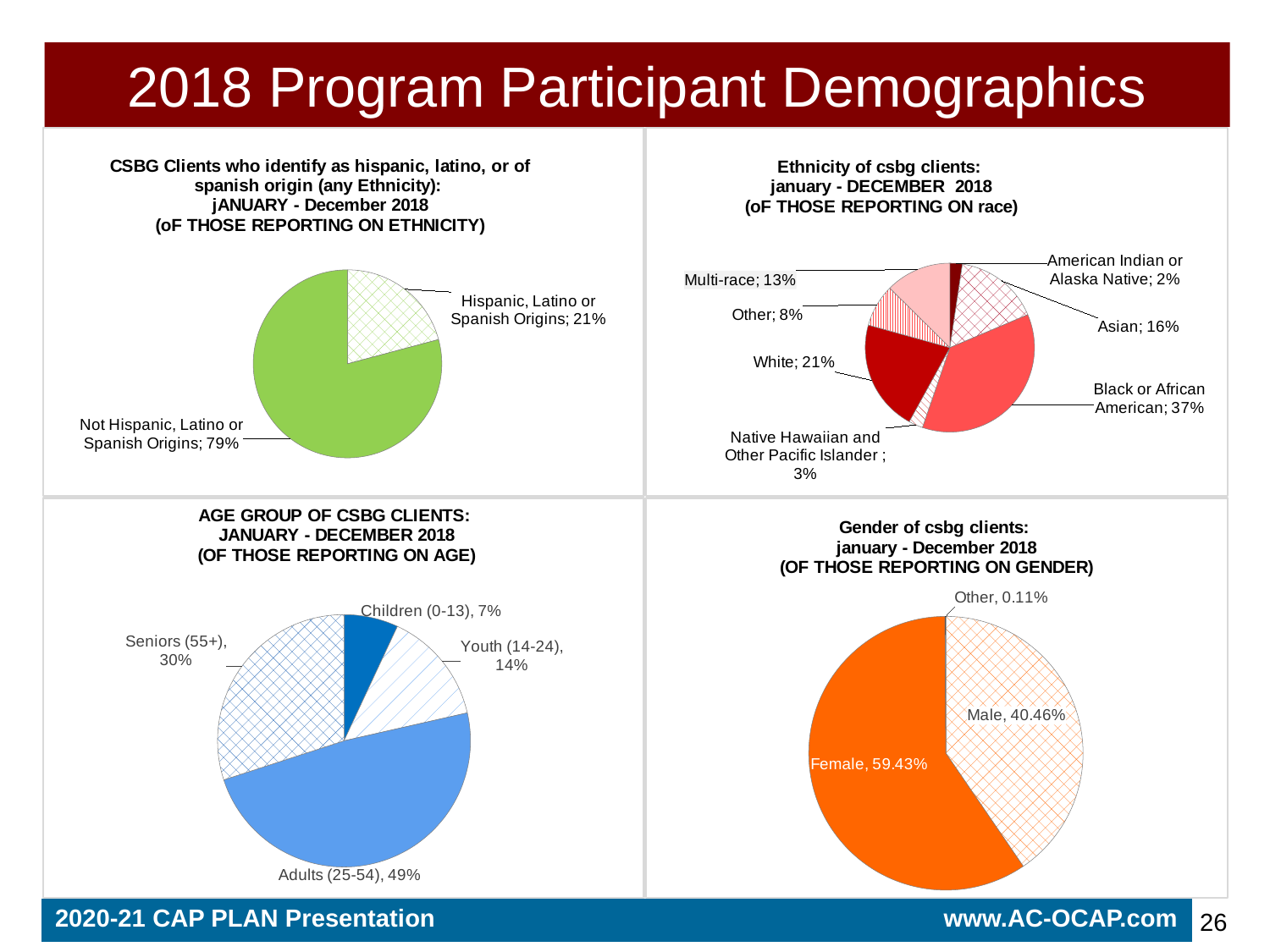
What kind of chart is used for the bottom-right chart (Gender of csbg clients)? Pie chart In the bottom-left pie chart (Age group of CSBG clients), which is larger, Youth (14-24) or Children (0-13)? Youth (14-24) In the bottom-left pie chart (Age group of CSBG clients), what is the difference between the Adults (25-54) share and the Seniors (55+) share? 19% In the top-right pie chart (Ethnicity of csbg clients), which category has the smallest share? American Indian or Alaska Native In the top-right pie chart (Ethnicity of csbg clients), how many categories are shown? 7 In the top-right pie chart (Ethnicity of csbg clients), what is the difference between the Black or African American share and the Asian share? 21% In the top-left pie chart (CSBG Clients who identify as hispanic, latino, or spanish origin), what share is labelled Not Hispanic, Latino or Spanish Origins? 79% In the bottom-right pie chart (Gender of csbg clients), what is the share for Male? 40.46% In the top-right pie chart (Ethnicity of csbg clients), what is the share for White? 21% In the bottom-left pie chart (Age group of CSBG clients), what is the share for Seniors (55+)? 30% In the top-right pie chart (Ethnicity of csbg clients), which category has the largest share? Black or African American In the top-left pie chart (CSBG Clients who identify as hispanic, latino, or spanish origin), what share is labelled Hispanic, Latino or Spanish Origins? 21%